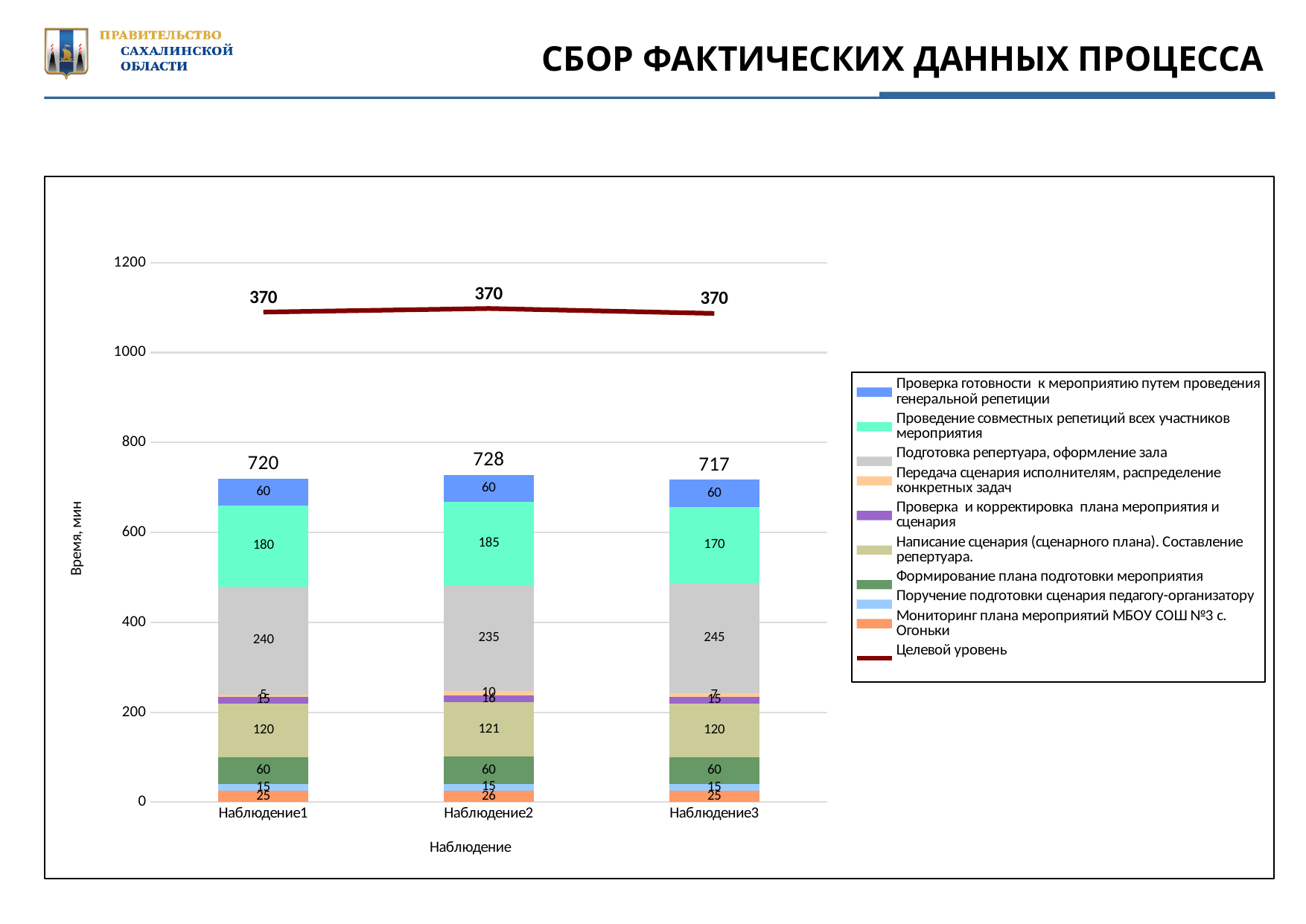
How many observation categories are shown on the x axis? 3 What is the value of the segment 'Подготовка репертуара, оформление зала' for Наблюдение3? 245 Which observation has the lowest total bar value? Наблюдение3 What value is labelled on the 'Целевой уровень' line for Наблюдение1? 370 For the segment 'Проведение совместных репетиций всех участников мероприятия', which is larger: Наблюдение1 or Наблюдение3? Наблюдение1 What kind of chart is shown on the slide? stacked bar chart with a line What is the difference between the total for Наблюдение2 and the total for Наблюдение3? 11 What is the total value shown above the bar for Наблюдение2? 728 What is the value of the segment 'Проведение совместных репетиций всех участников мероприятия' for Наблюдение2? 185 How many entries does the legend list? 10 What is the title of the vertical axis? Время, мин Which observation has the highest total bar value? Наблюдение2